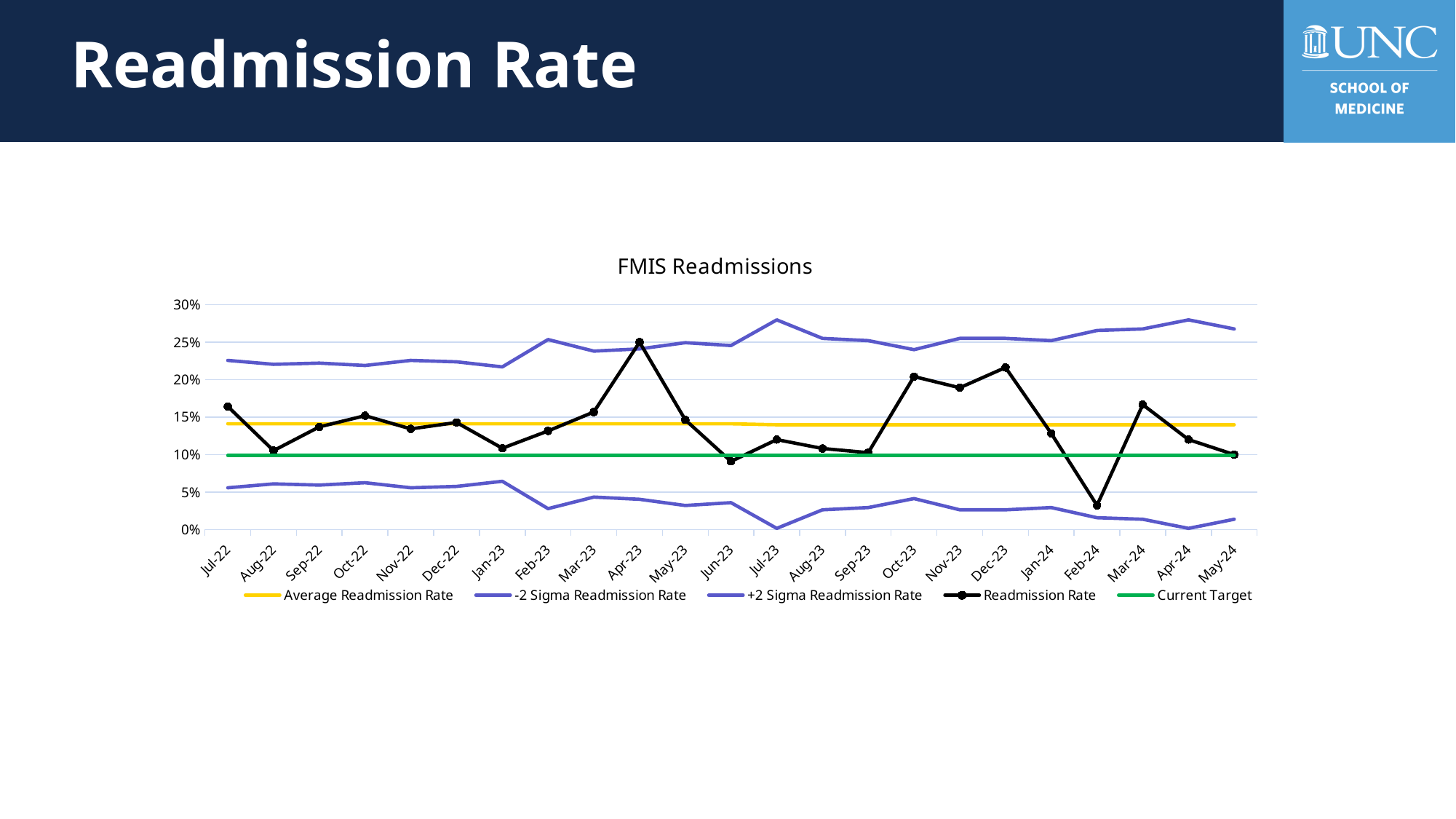
Which month has a higher Readmission Rate, Oct-23 or Aug-23? Oct-23 Is the Readmission Rate for Feb-24 greater or less than 5%? less Is the Readmission Rate for Jun-23 greater or less than 10%? less Is the Readmission Rate for Jul-22 greater or less than 15%? greater What kind of chart is shown on the slide? line chart How many months are plotted along the x axis? 23 What is the title of the chart? FMIS Readmissions In which month is the Readmission Rate highest? Apr-23 How many series does the legend list? 5 In which month is the Readmission Rate lowest? Feb-24